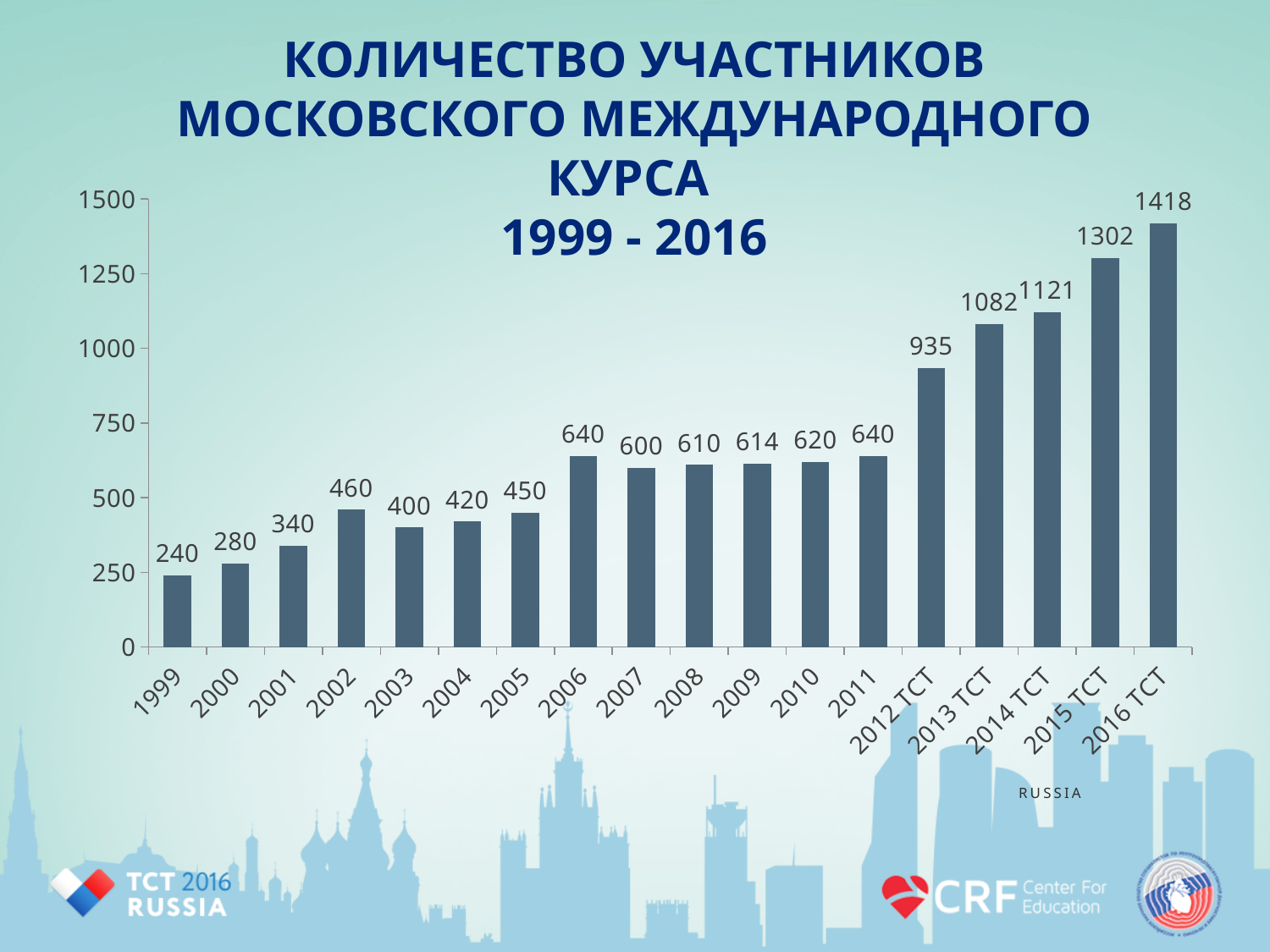
What is the number of participants in 2006? 640 What kind of chart is shown on the slide? bar chart How many years (bars) are shown in the chart? 18 What is the number of participants in 1999? 240 Is the value for 2013 TCT greater or less than 1000? greater Do the values generally rise or fall from 1999 to 2016 TCT? rise What is the number of participants in 2014 TCT? 1121 Which is larger, the value for 2002 or the value for 2003? 2002 What is the difference between the values for 2012 TCT and 2011? 295 What is the difference between the values for 2016 TCT and 2015 TCT? 116 Which year has the lowest number of participants? 1999 Which year has the highest number of participants? 2016 TCT